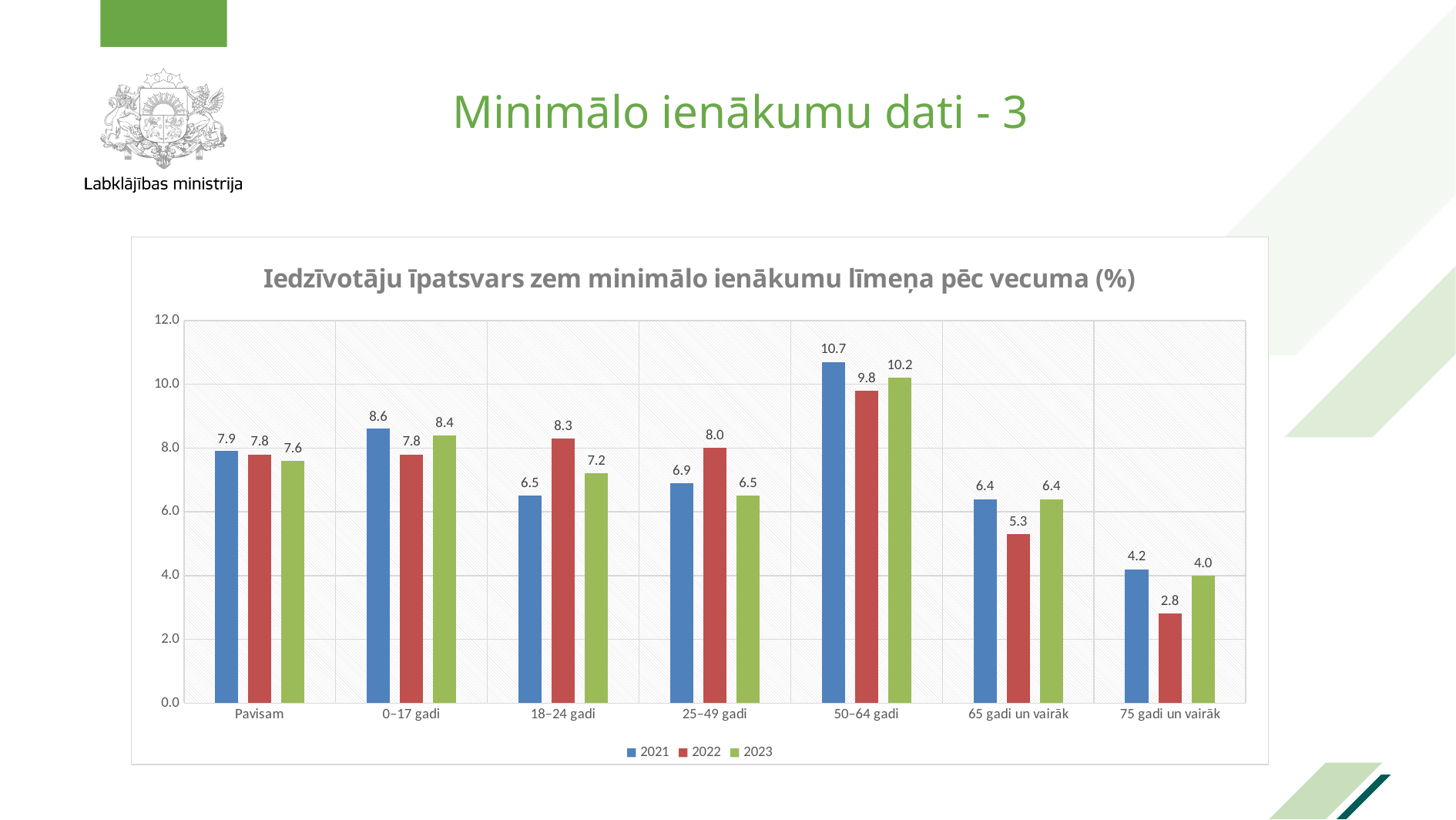
In the 18–24 gadi category, which is larger: the 2022 value or the 2023 value? 2022 What is the title of the chart? Iedzīvotāju īpatsvars zem minimālo ienākumu līmeņa pēc vecuma (%) How many series does the legend list? 3 What is the value for 2021 in the 50–64 gadi category? 10.7 Which category has the highest value for the 2023 series? 50–64 gadi What is the value for 2022 in the 75 gadi un vairāk category? 2.8 Which category has the lowest value for the 2022 series? 75 gadi un vairāk What is the value for 2023 in the 0–17 gadi category? 8.4 Is the value for 2021 in the 25–49 gadi category greater or less than 8.0? less How many categories are shown on the x axis? 7 What kind of chart is shown on the slide? bar chart What is the difference between the 2021 and 2022 values in the 65 gadi un vairāk category? 1.1